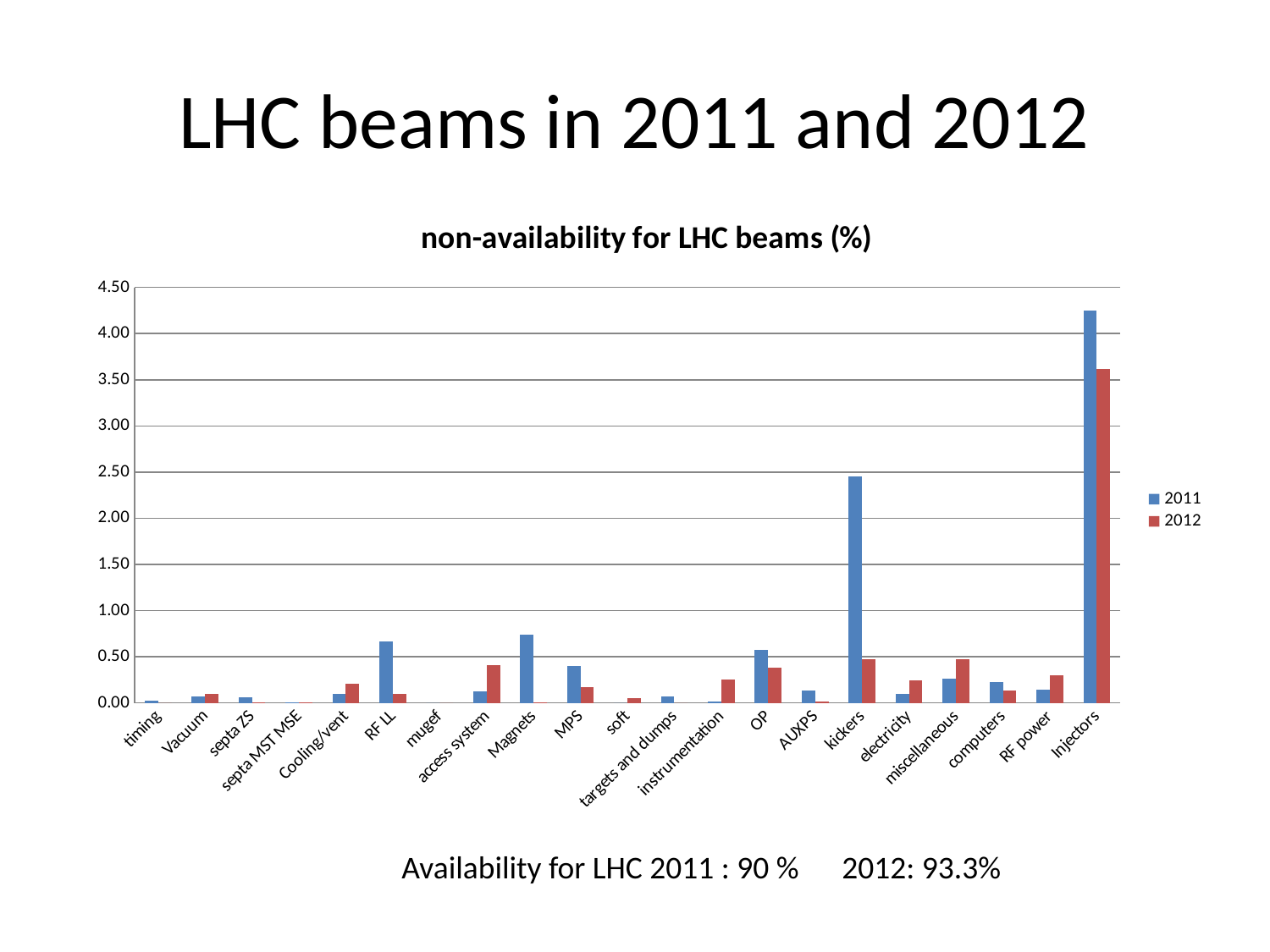
What is the title of the chart? non-availability for LHC beams (%) Is the 2012 value for kickers greater or less than 1.00? less Is the 2011 value for Injectors greater or less than 4.00? greater For access system, which series has the larger value, 2011 or 2012? 2012 For kickers, which series has the larger value, 2011 or 2012? 2011 How many series does the legend list? 2 Is the 2012 value for Injectors greater or less than 3.50? greater Which category has the highest value for the 2011 series? Injectors What kind of chart is shown on the slide? bar chart How many categories are shown on the x axis? 21 Which category has the highest value for the 2012 series? Injectors